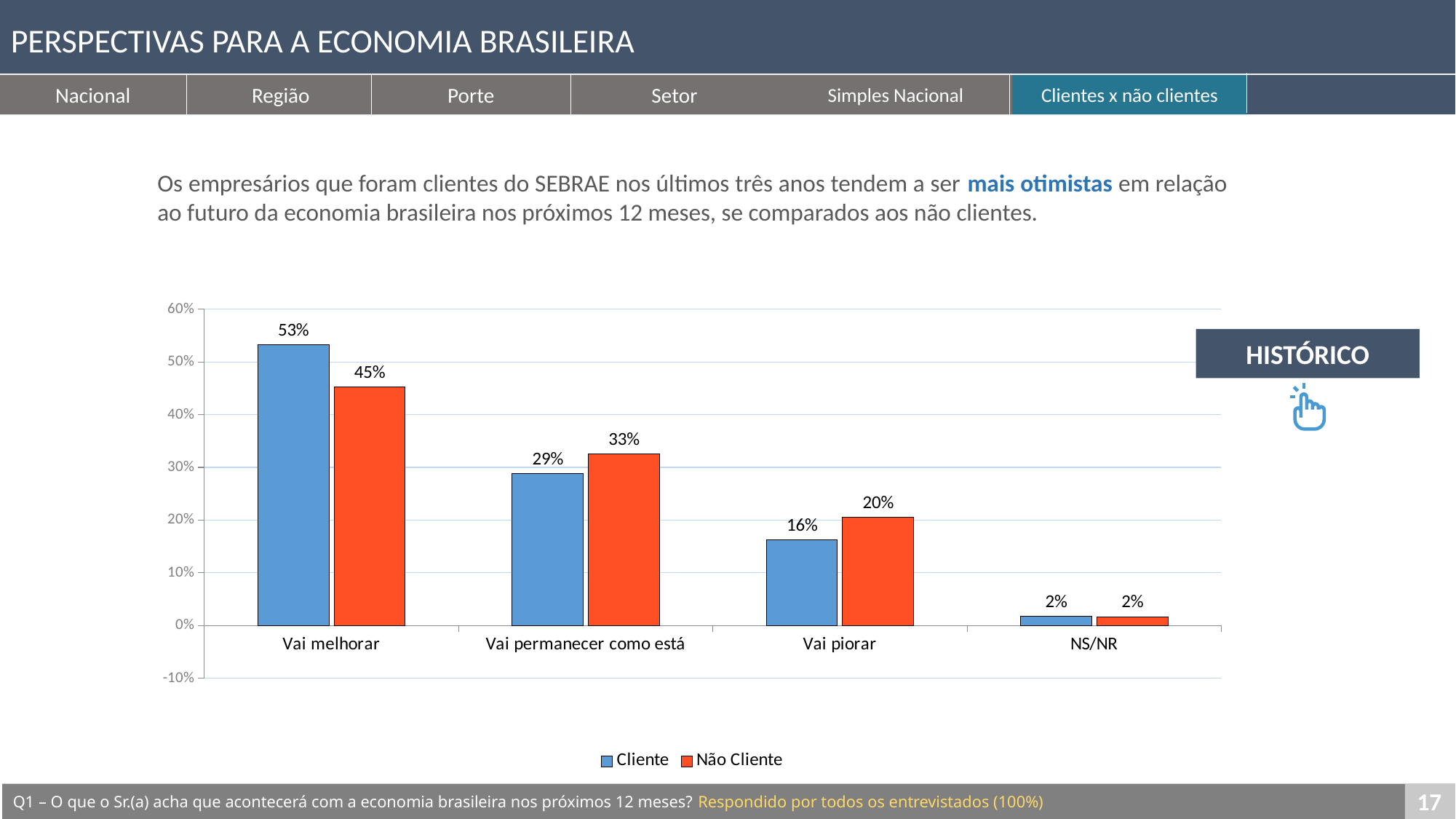
In the 'Vai permanecer como está' category, which series has the larger value, Cliente or Não Cliente? Não Cliente How many categories are shown on the x axis? 4 What is the difference between Cliente and Não Cliente in the 'Vai melhorar' category? 8% What is the value for Cliente in the 'Vai piorar' category? 16% What is the difference between Não Cliente and Cliente in the 'Vai piorar' category? 4% How many series does the legend list? 2 Which category has the highest value for Não Cliente? Vai melhorar Which category has the lowest value for Cliente? NS/NR Which colour represents the Não Cliente series in the legend? Orange-red What kind of chart is shown on the slide? Bar chart What is the value for Não Cliente in the 'Vai permanecer como está' category? 33% What is the value for Cliente in the 'Vai melhorar' category? 53%